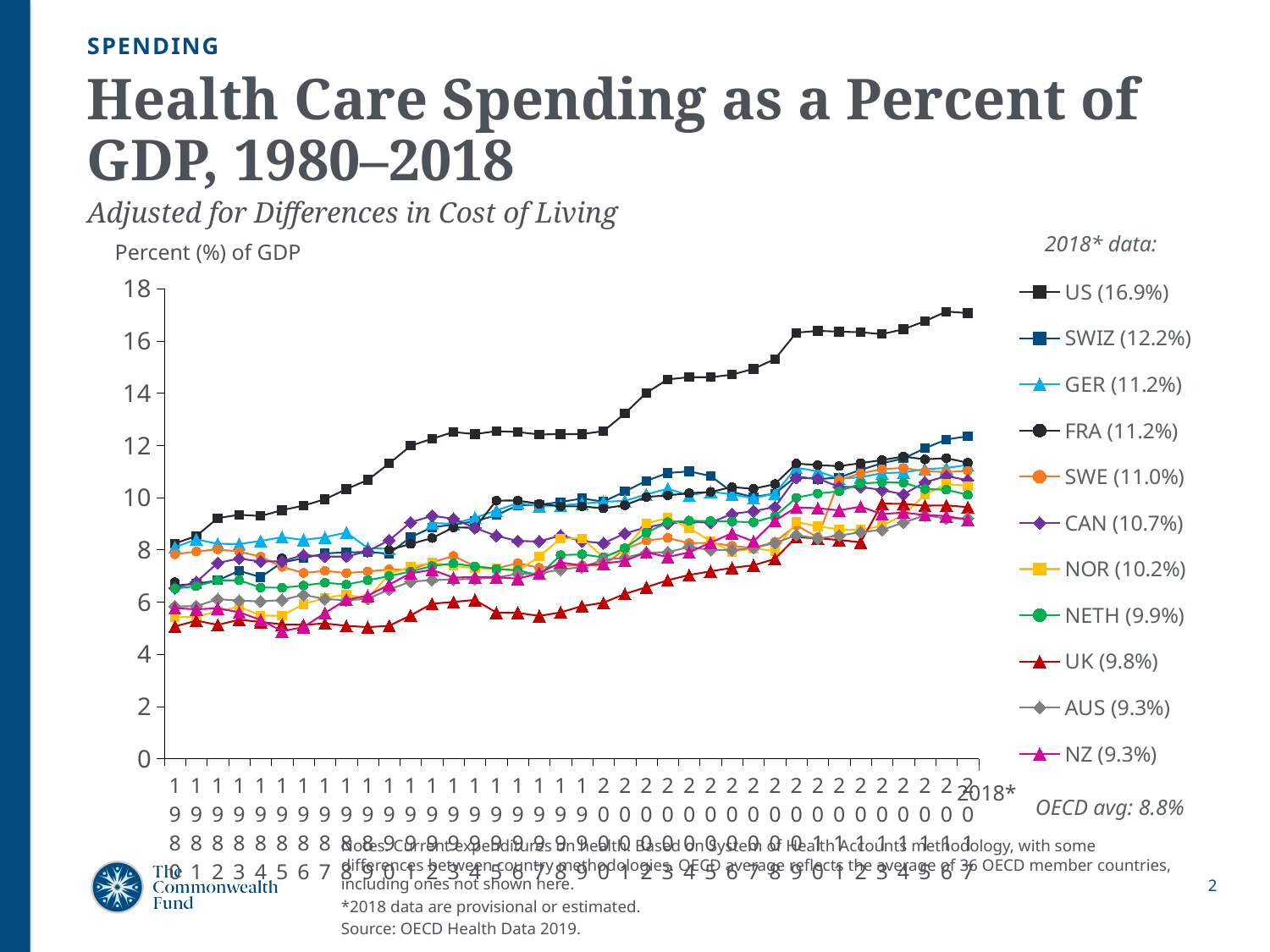
Does the US line rise or fall from 1980 to 2018? Rises What is the OECD average shown on the slide for 2018? 8.8% What is the difference between the 2018 values for the US and SWIZ? 4.7 percentage points Which has the larger 2018 value, CAN or NOR? CAN According to the legend, what was US health care spending as a percent of GDP in 2018? 16.9% How many countries (series) does the legend list? 11 Which country has the highest health care spending as a percent of GDP in 2018? US What is the 2018 value shown for NETH? 9.9% What type of chart is shown on the slide? Line chart What is the 2018 value shown for SWIZ in the legend? 12.2% Is the US value in 1980 greater or less than 10? less What is the label on the vertical axis of the chart? Percent (%) of GDP